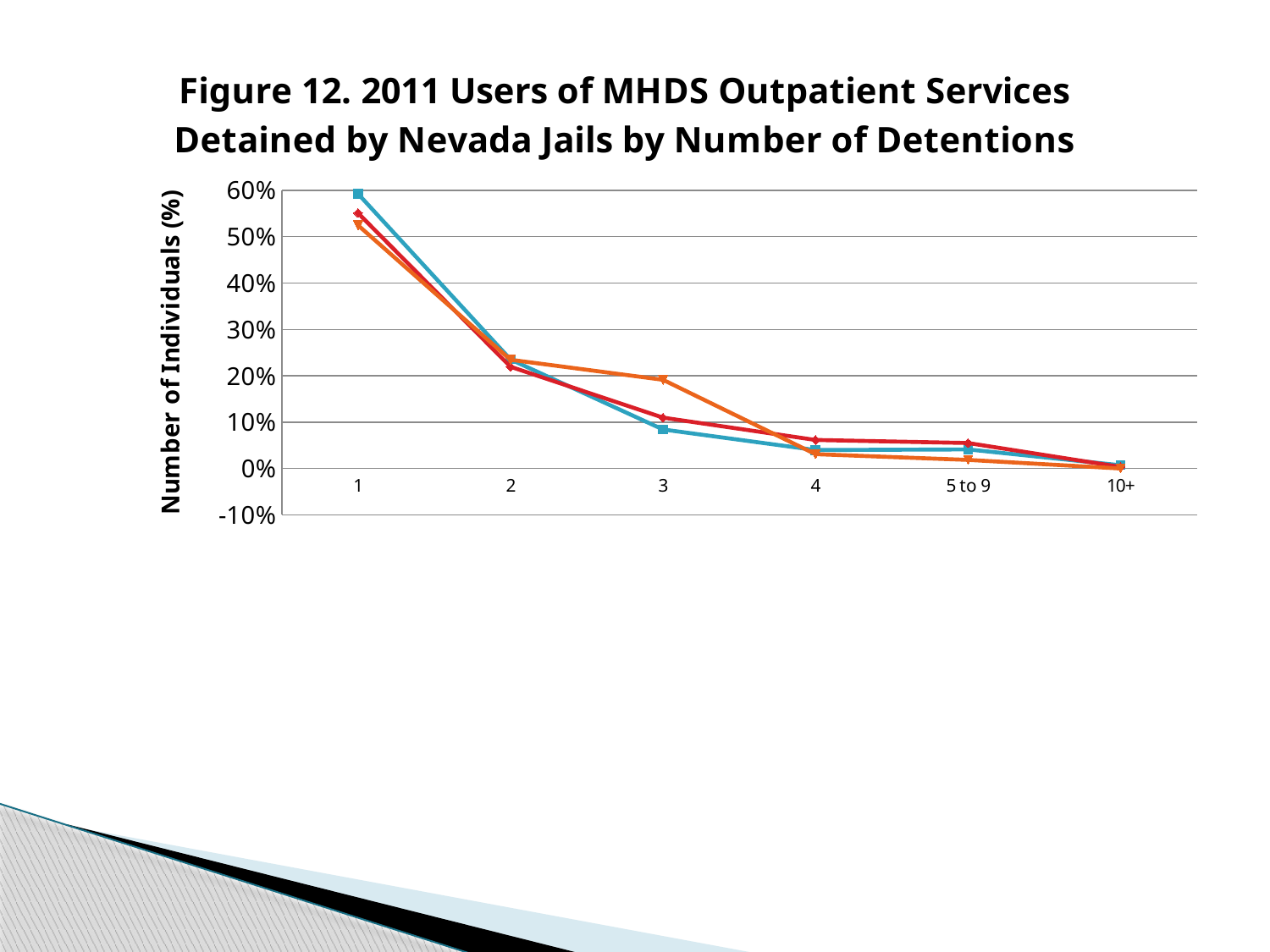
What kind of chart is shown on the slide? line chart What is the title of the chart? Figure 12. 2011 Users of MHDS Outpatient Services Detained by Nevada Jails by Number of Detentions What is the label on the vertical axis? Number of Individuals (%) Is the value of the blue line at category 3 greater or less than 10%? less At category 1, which line has the larger value, the blue line or the orange line? blue line Is the value of the blue line at category 1 greater or less than 50%? greater Do the values of the blue line rise or fall as the number of detentions increases along the x axis? fall At category 3, which line has the larger value, the orange line or the blue line? orange line Is the value of the orange line at category 3 greater or less than 10%? greater Which category has the lowest value for the orange line? 10+ Which category has the highest value for the blue line? 1 How many categories are shown on the x axis? 6